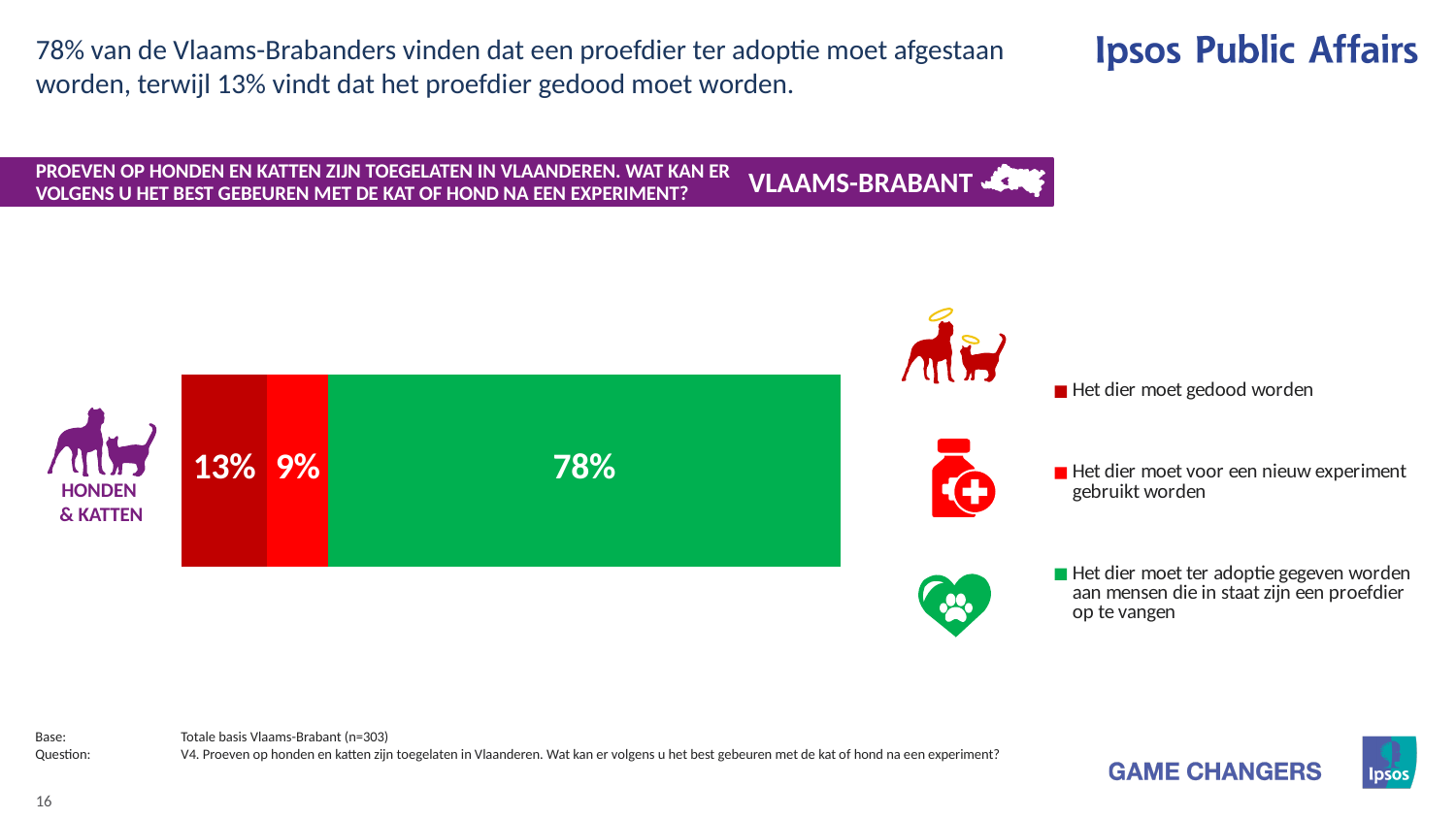
What colour is the segment for "Het dier moet ter adoptie gegeven worden"? Green What percentage of respondents say the animal should be put up for adoption ("Het dier moet ter adoptie gegeven worden")? 78% Which is larger: the share for "Het dier moet gedood worden" or the share for "Het dier moet voor een nieuw experiment gebruikt worden"? Het dier moet gedood worden What is the total of the three segments in the stacked bar? 100% What is the difference between the share for adoption (78%) and the share for killing the animal (13%)? 65 percentage points Which answer option has the lowest share in the bar? Het dier moet voor een nieuw experiment gebruikt worden Which answer option has the highest share in the bar? Het dier moet ter adoptie gegeven worden What percentage of respondents say the animal should be used for a new experiment ("Het dier moet voor een nieuw experiment gebruikt worden")? 9% What percentage of respondents say the animal should be killed ("Het dier moet gedood worden")? 13% What kind of chart is shown on the slide? Stacked bar chart How many series does the legend list? 3 What is the label of the category shown next to the bar? HONDEN & KATTEN